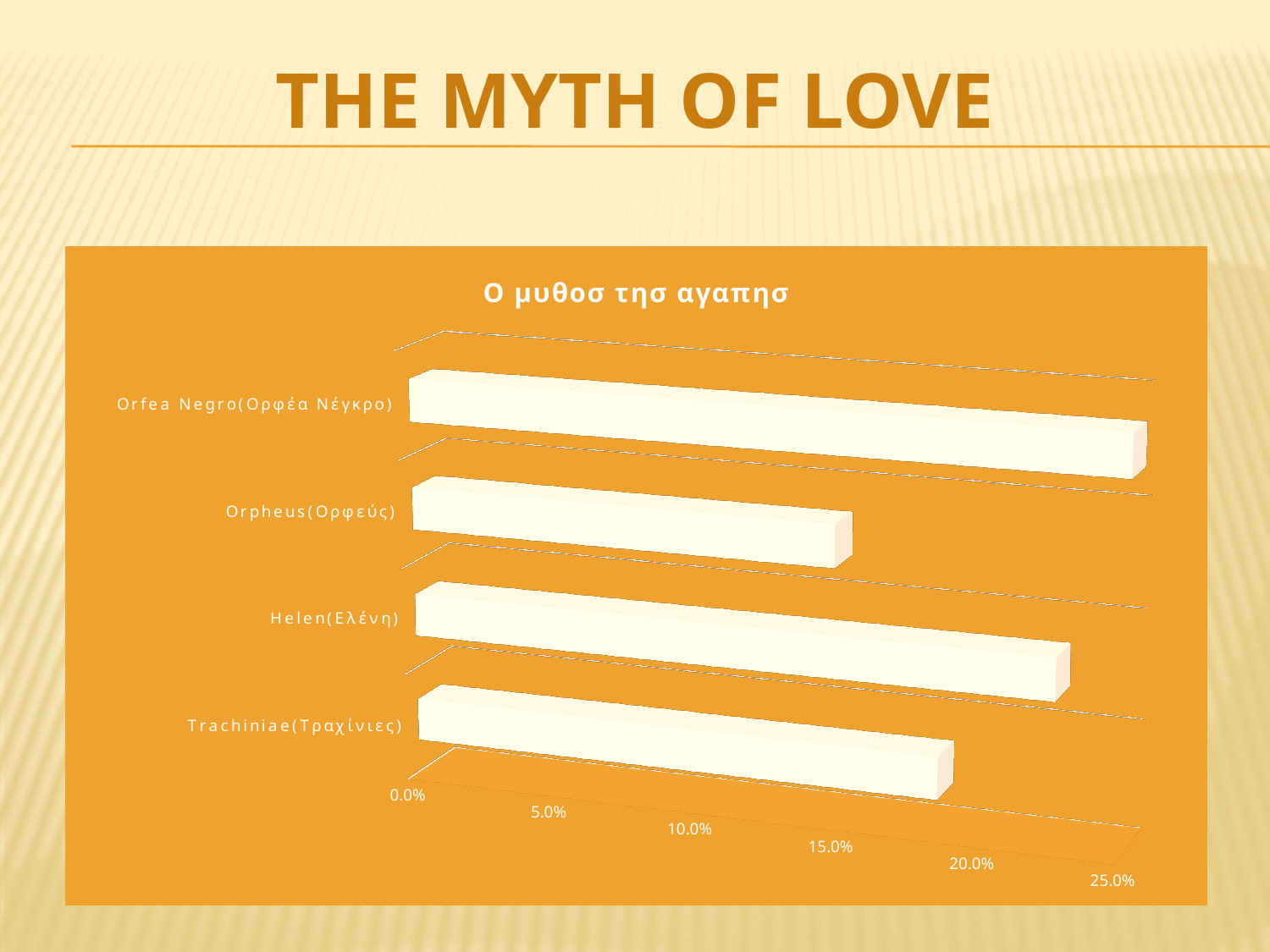
What is the title of the chart? Ο μυθοσ τησ αγαπησ Is the value for Orpheus(Ορφεύς) greater or less than 20.0%? less Which category has the lowest value in the chart? Orpheus(Ορφεύς) Is the value for Orfea Negro(Ορφέα Νέγκρο) greater or less than 20.0%? greater Is the value for Trachiniae(Τραχίνιες) greater or less than 10.0%? greater What is the highest value shown on the chart's value axis? 25.0% What kind of chart is shown on the slide? Bar chart Which category has the highest value in the chart? Orfea Negro(Ορφέα Νέγκρο) Which has the larger value, Helen(Ελένη) or Orpheus(Ορφεύς)? Helen(Ελένη) Which has the larger value, Orfea Negro(Ορφέα Νέγκρο) or Trachiniae(Τραχίνιες)? Orfea Negro(Ορφέα Νέγκρο) How many categories are plotted in the chart? 4